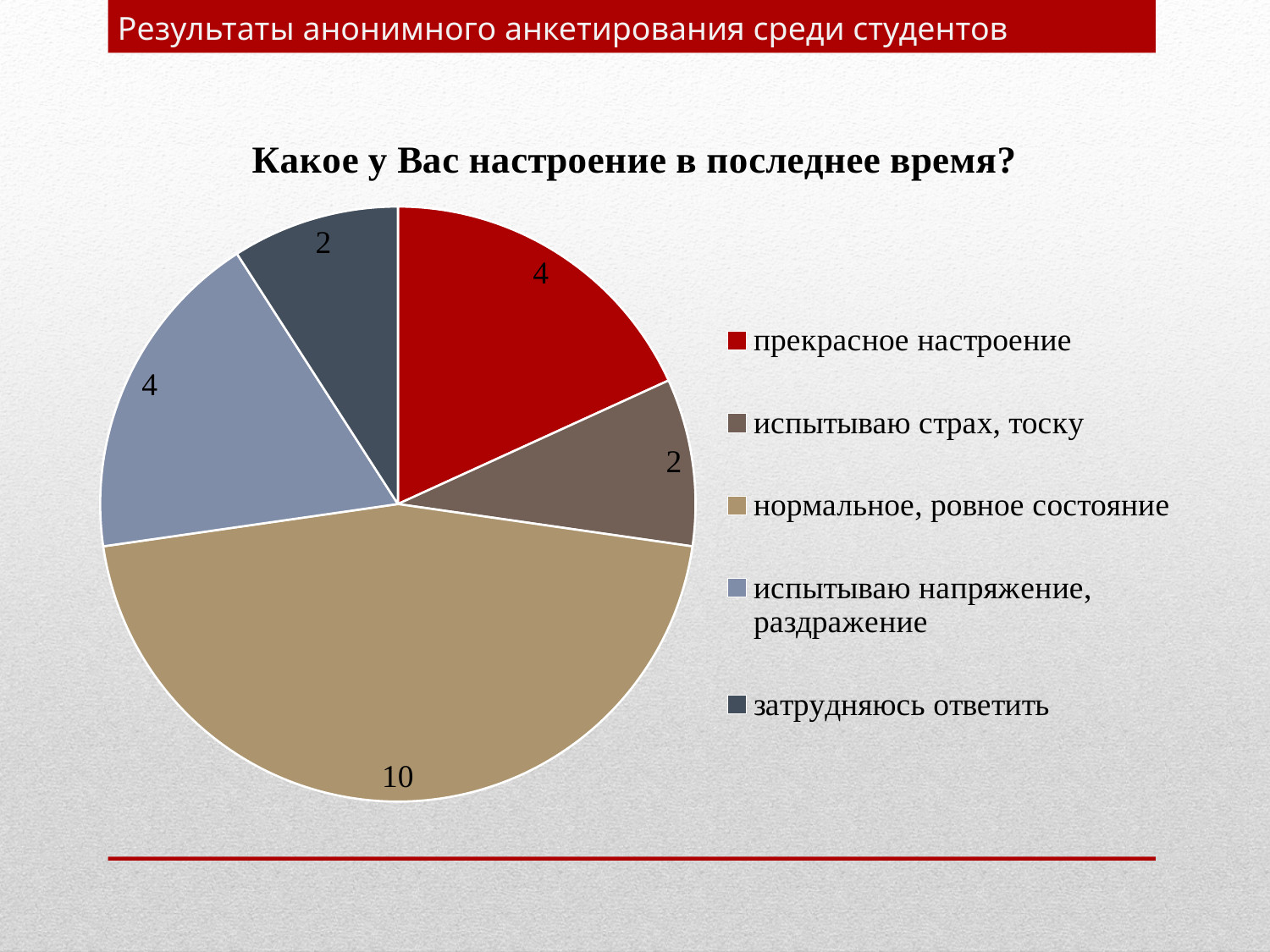
Which is larger: the value for 'прекрасное настроение' or the value for 'испытываю страх, тоску'? прекрасное настроение What is the difference between the values for 'нормальное, ровное состояние' and 'прекрасное настроение'? 6 What is the value for 'нормальное, ровное состояние'? 10 What is the value for 'прекрасное настроение'? 4 What is the value for 'испытываю страх, тоску'? 2 What type of chart is shown on the slide? pie chart What is the value for 'испытываю напряжение, раздражение'? 4 What is the total of all the values shown in the pie chart? 22 What is the title of the chart? Какое у Вас настроение в последнее время? What is the value for 'затрудняюсь ответить'? 2 Which category has the largest slice of the pie? нормальное, ровное состояние How many categories does the pie chart have? 5